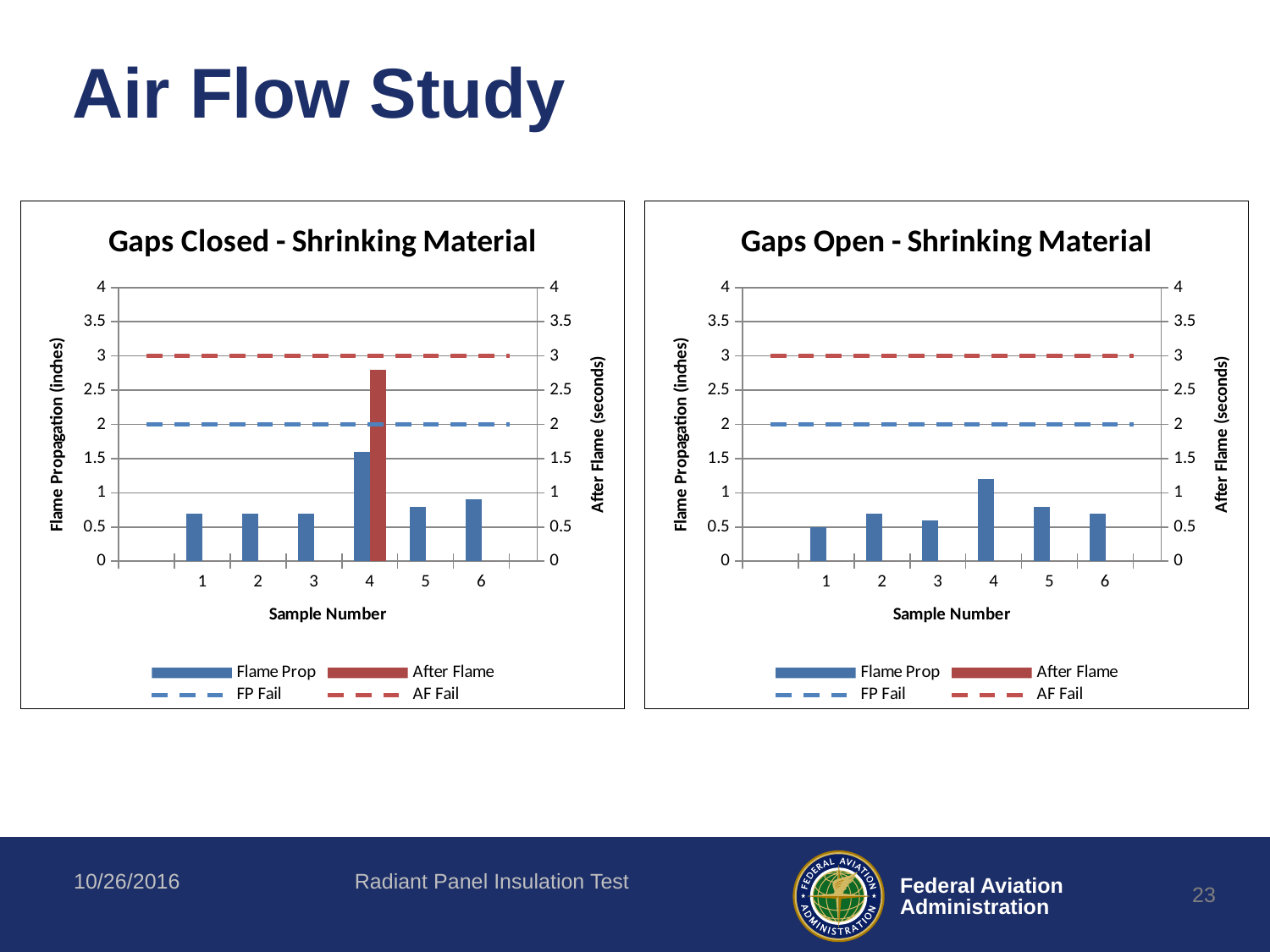
In the Gaps Open - Shrinking Material chart, is the Flame Prop value for sample 1 greater or less than 1? less In the Gaps Closed - Shrinking Material chart, at what value is the FP Fail dashed line drawn? 2 In the Gaps Open - Shrinking Material chart, is the Flame Prop value for sample 4 greater or less than 1? greater What kind of chart is the Gaps Open - Shrinking Material chart? bar chart In the Gaps Closed - Shrinking Material chart, is the After Flame value for sample 4 greater or less than 3? less In the Gaps Closed - Shrinking Material chart, which sample number has the highest Flame Prop value? 4 In the Gaps Closed - Shrinking Material chart, how many entries does the legend list? 4 In the Gaps Open - Shrinking Material chart, at what value is the AF Fail dashed line drawn? 3 In the Gaps Open - Shrinking Material chart, which sample number has the highest Flame Prop value? 4 In the Gaps Closed - Shrinking Material chart, how many sample numbers are shown on the x axis? 6